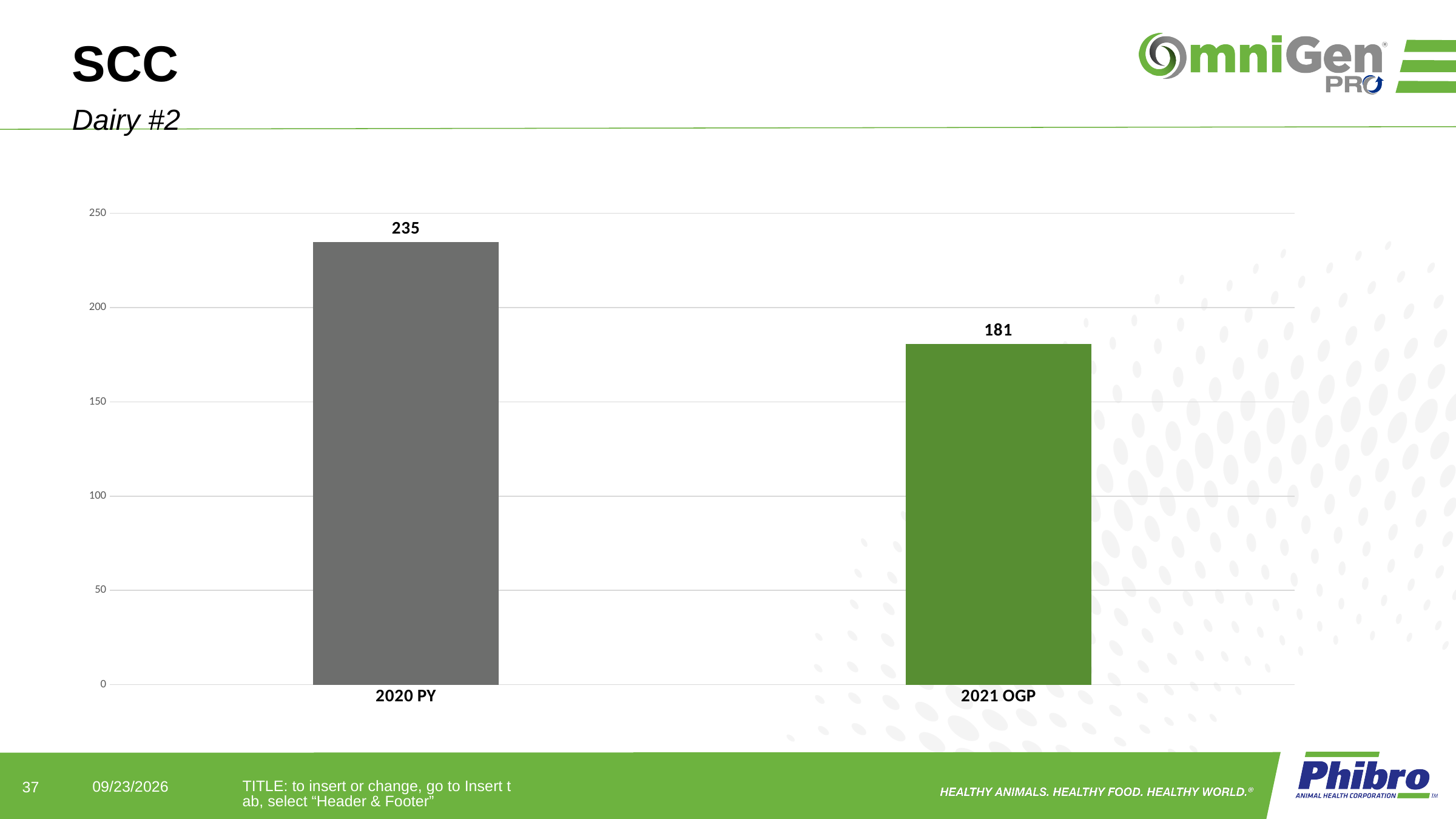
How many categories are shown on the x axis? 2 Do the values rise or fall from 2020 PY to 2021 OGP? fall What is the difference between the values for 2020 PY and 2021 OGP? 54 What is the value for 2020 PY? 235 What is the value for 2021 OGP? 181 Which is larger, the value for 2020 PY or the value for 2021 OGP? 2020 PY What colour is the bar for 2021 OGP? green Is the value for 2021 OGP greater or less than 200? less What kind of chart is shown on the slide? bar chart Which category has the highest value? 2020 PY Which category has the lowest value? 2021 OGP Is the value for 2020 PY greater or less than 200? greater